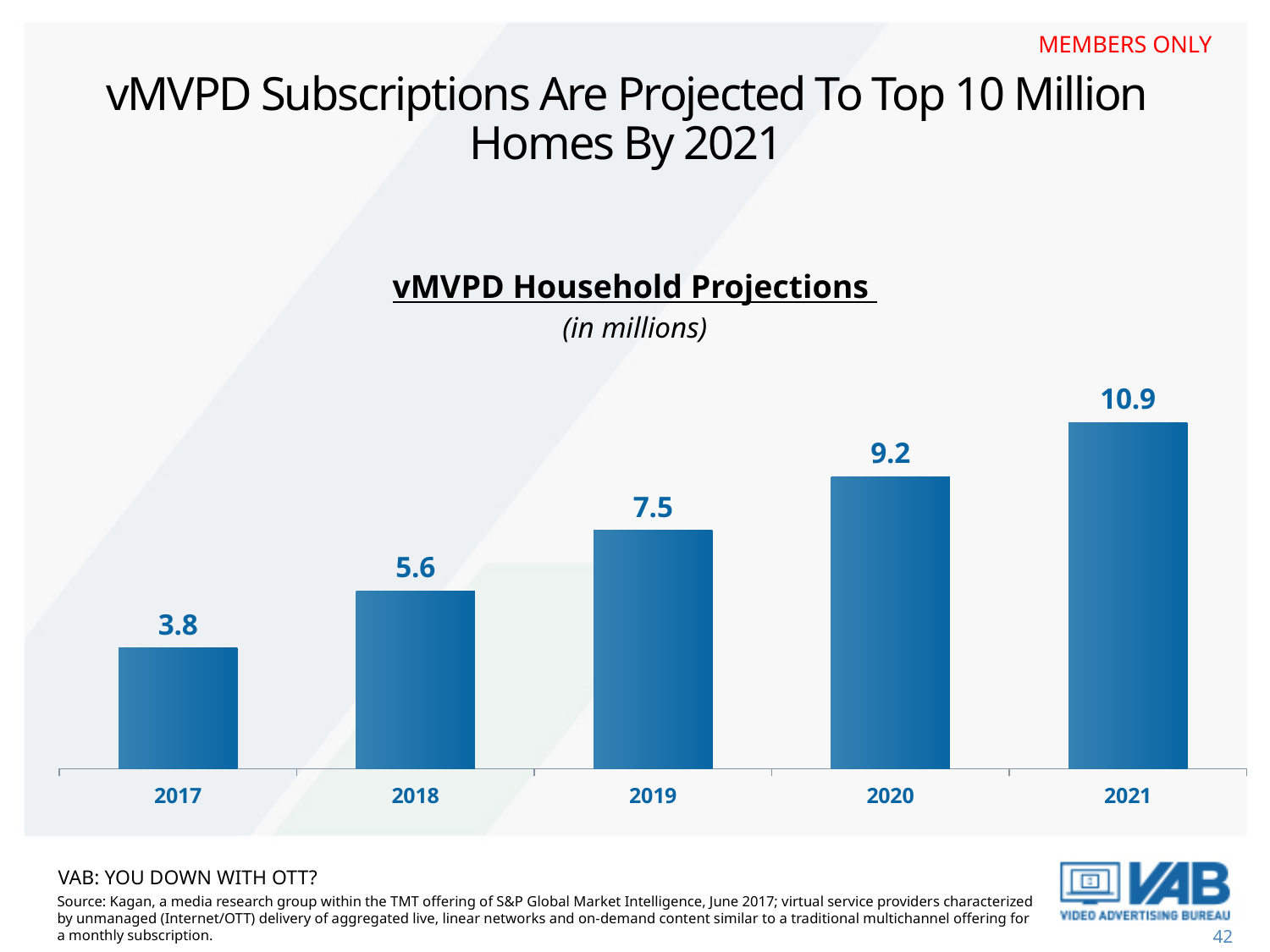
What kind of chart is shown on the slide? Bar chart Which year has the lowest value in the chart? 2017 What is the value shown for 2021? 10.9 How many years are shown on the x axis of the chart? 5 Which year has the highest projected vMVPD households? 2021 What is the projected number of vMVPD households (in millions) for 2019? 7.5 What is the difference between the 2021 and 2017 values? 7.1 Which is larger, the value for 2018 or the value for 2020? 2020 What is the value shown for 2017 in the vMVPD Household Projections chart? 3.8 What is the difference between the 2020 and 2019 values? 1.7 Do the values rise or fall from 2017 to 2021? Rise What is the title of the chart? vMVPD Household Projections